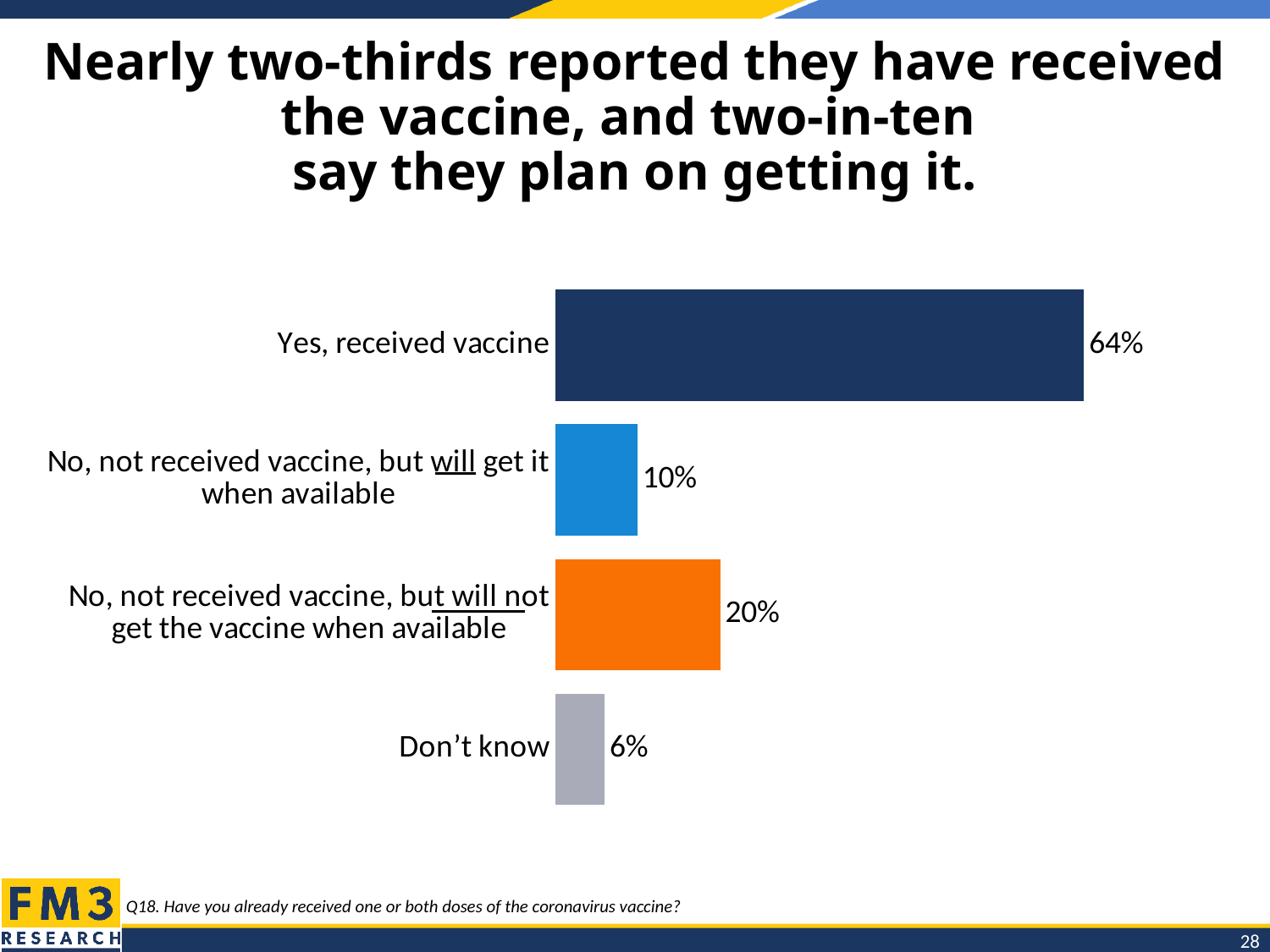
Which response category has the lowest value? Don't know How many response categories are shown in the chart? 4 Which is larger: the share who will get the vaccine when available or the share who will not get it? Will not get the vaccine when available What percentage said they have not received the vaccine but will get it when available? 10% Which response category has the highest value? Yes, received vaccine What percentage said they have not received the vaccine and will not get it when available? 20% What type of chart is shown on the slide? Bar chart What is the difference between the share who received the vaccine and the share who will not get it when available? 44 percentage points What is the difference between the "will not get the vaccine" share and the "will get it when available" share? 10 percentage points What percentage of respondents said "Yes, received vaccine"? 64% What survey question is the chart based on, as noted at the bottom of the slide? Q18. Have you already received one or both doses of the coronavirus vaccine? What percentage of respondents answered "Don't know"? 6%